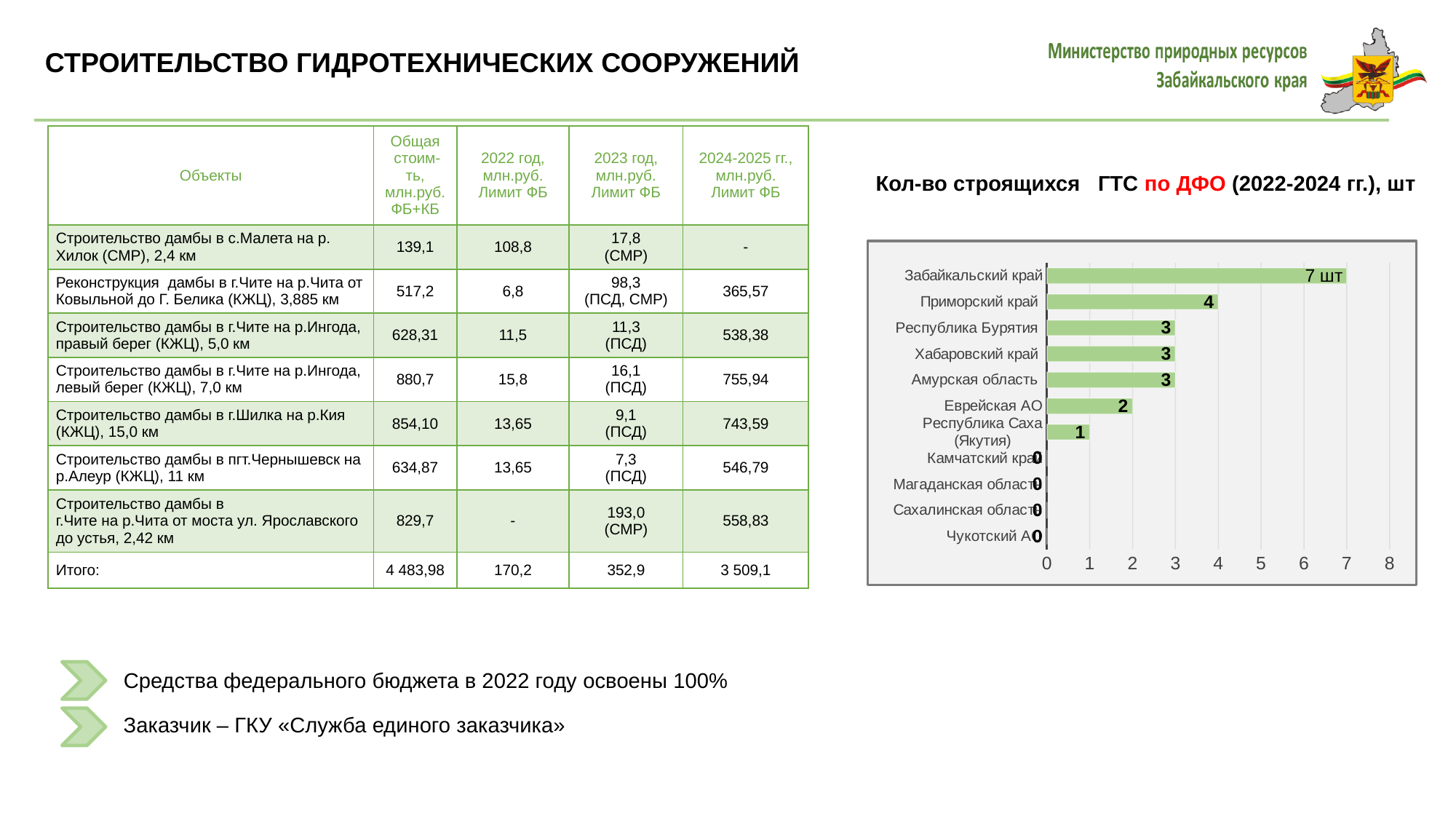
What is the value for Амурская область in the chart? 3 What is the value for Забайкальский край in the chart? 7 шт How many regions (categories) are shown in the chart? 11 What is the value for Приморский край in the chart? 4 How many regions in the chart have a value of 0? 4 What is the value for Еврейская АО in the chart? 2 Which is larger, the value for Приморский край or the value for Хабаровский край? Приморский край What is the value for Республика Саха (Якутия) in the chart? 1 What type of chart is shown on the slide? bar chart What is the title of the chart? Кол-во строящихся ГТС по ДФО (2022-2024 гг.), шт What is the difference between the values for Забайкальский край and Приморский край? 3 Which region has the highest number of ГТС under construction in the chart? Забайкальский край